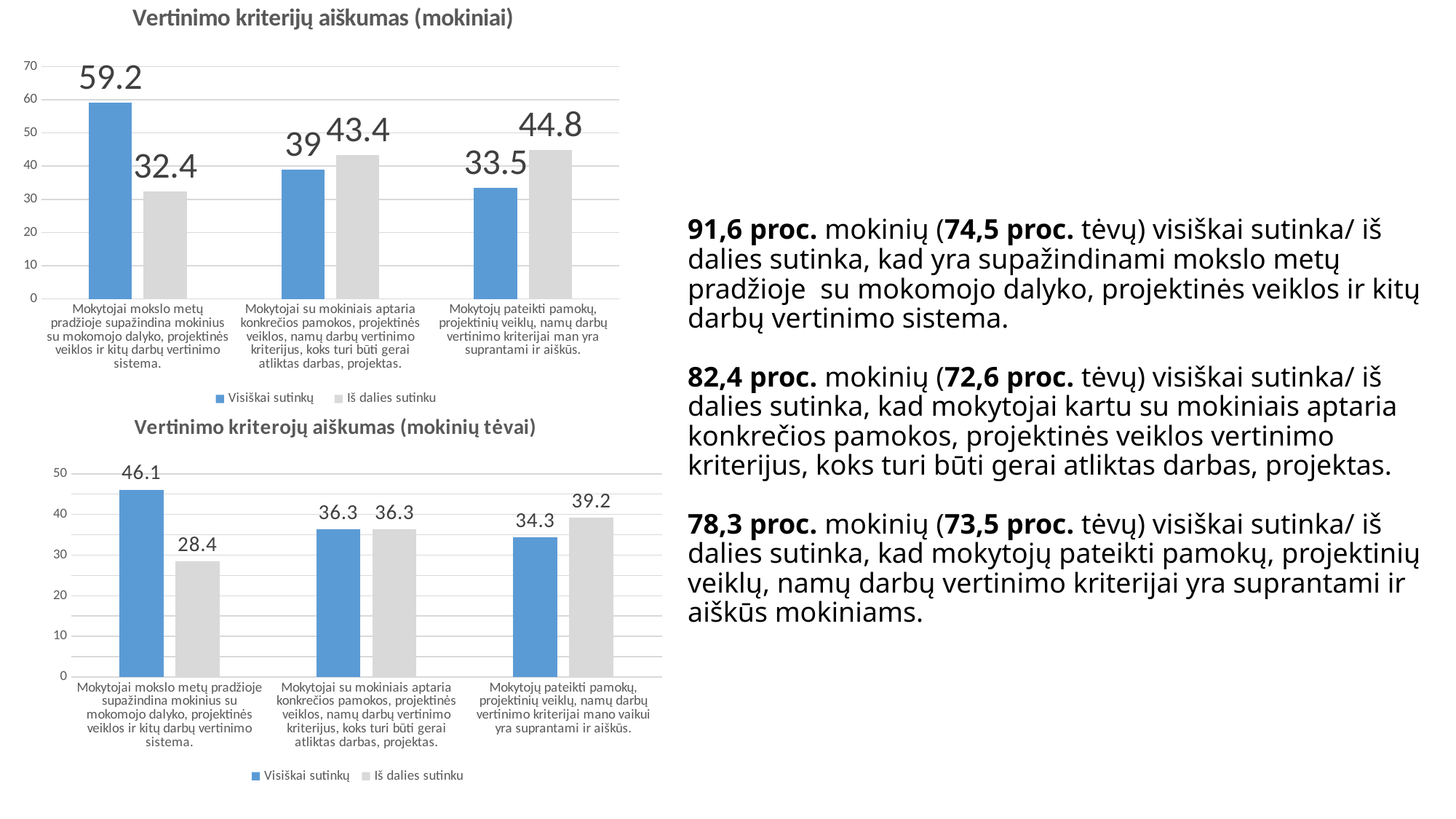
In the top chart (Vertinimo kriterijų aiškumas (mokiniai)), for the second category (Mokytojai su mokiniais aptaria...), which is larger: 'Visiškai sutinku' or 'Iš dalies sutinku'? Iš dalies sutinku How many categories are shown on the x axis of the top chart (Vertinimo kriterijų aiškumas (mokiniai))? 3 In the top chart (Vertinimo kriterijų aiškumas (mokiniai)), what is the value of 'Visiškai sutinku' for the first category (Mokytojai mokslo metų pradžioje supažindina mokinius...)? 59.2 In the top chart (Vertinimo kriterijų aiškumas (mokiniai)), which category has the highest 'Visiškai sutinku' value? Mokytojai mokslo metų pradžioje supažindina mokinius su mokomojo dalyko, projektinės veiklos ir kitų darbų vertinimo sistema. What kind of chart is the top chart (Vertinimo kriterijų aiškumas (mokiniai))? Bar chart How many series does the legend of the bottom chart (Vertinimo kriterojų aiškumas (mokinių tėvai)) list? 2 In the top chart (Vertinimo kriterijų aiškumas (mokiniai)), what is the value of 'Iš dalies sutinku' for the third category (Mokytojų pateikti pamokų... kriterijai man yra suprantami ir aiškūs)? 44.8 In the bottom chart (Vertinimo kriterojų aiškumas (mokinių tėvai)), what is the difference between 'Iš dalies sutinku' and 'Visiškai sutinku' for the third category? 4.9 In the bottom chart (Vertinimo kriterojų aiškumas (mokinių tėvai)), what is the value of 'Iš dalies sutinku' for the first category? 28.4 In the top chart (Vertinimo kriterijų aiškumas (mokiniai)), what is the difference between the 'Visiškai sutinku' and 'Iš dalies sutinku' values for the first category? 26.8 In the bottom chart (Vertinimo kriterojų aiškumas (mokinių tėvai)), which category has the lowest 'Iš dalies sutinku' value? Mokytojai mokslo metų pradžioje supažindina mokinius su mokomojo dalyko, projektinės veiklos ir kitų darbų vertinimo sistema. In the bottom chart (Vertinimo kriterojų aiškumas (mokinių tėvai)), what is the value of 'Visiškai sutinku' for the third category (Mokytojų pateikti pamokų... mano vaikui yra suprantami ir aiškūs)? 34.3